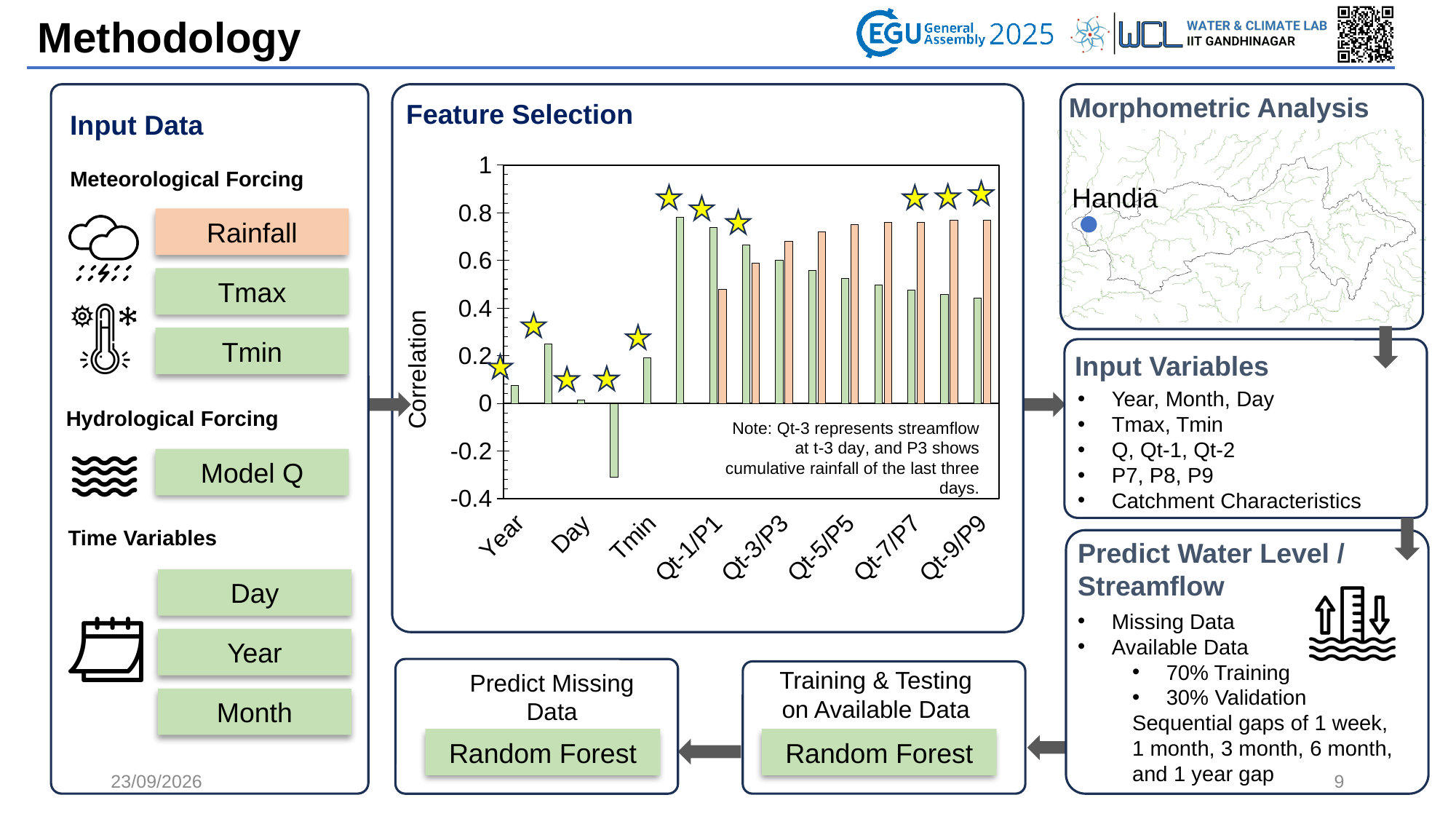
In the Feature Selection chart, is the orange bar at Qt-9/P9 greater or less than 0.6? greater In the Feature Selection chart, which bar is larger at Qt-1/P1, the green bar or the orange bar? the green bar In the Feature Selection chart, which bar is larger at Qt-7/P7, the green bar or the orange bar? the orange bar In the Feature Selection chart, which has the higher correlation, Year or Tmin? Tmin In the Feature Selection chart, is the green bar at Qt-1/P1 greater or less than 0.6? greater In the Feature Selection chart, do the green bars rise or fall from Qt-1/P1 to Qt-9/P9? fall What kind of chart is shown in the Feature Selection panel? bar chart How many category labels are printed along the x-axis of the Feature Selection chart? 8 In the Feature Selection chart, is the correlation value for Year greater or less than 0.2? less What is the label on the y-axis of the Feature Selection chart? Correlation